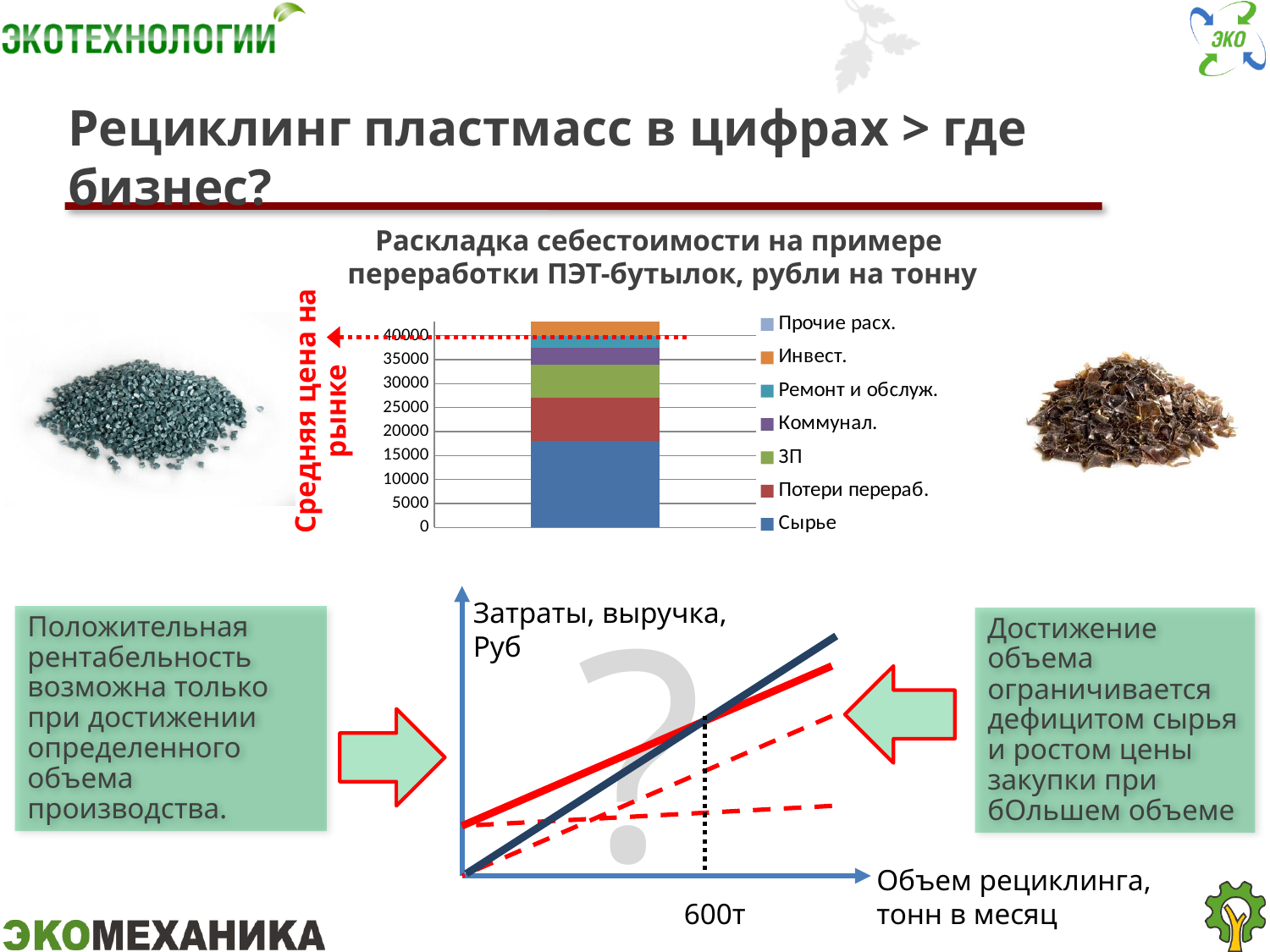
What is the title of the stacked bar chart? Раскладка себестоимости на примере переработки ПЭТ-бутылок, рубли на тонну In the stacked bar chart, is the value for Сырье greater or less than 20000? less In the stacked bar chart, is the value for Сырье greater or less than 15000? greater How many series does the legend of the stacked bar chart list? 7 What kind of chart is the 'Раскладка себестоимости на примере переработки ПЭТ-бутылок, рубли на тонну' chart? Stacked bar chart In the stacked bar chart, which segment is larger: ЗП or Ремонт и обслуж.? ЗП What does the red dotted horizontal line on the stacked bar chart represent, according to its label? Средняя цена на рынке In the stacked bar chart, which cost component is the largest segment of the bar? Сырье In the stacked bar chart, is the total height of the stacked bar greater or less than 40000? greater In the stacked bar chart, which segment is larger: Сырье or ЗП? Сырье In the stacked bar chart, which segment is larger: Потери перераб. or Коммунал.? Потери перераб. How many bars are plotted in the stacked bar chart? 1